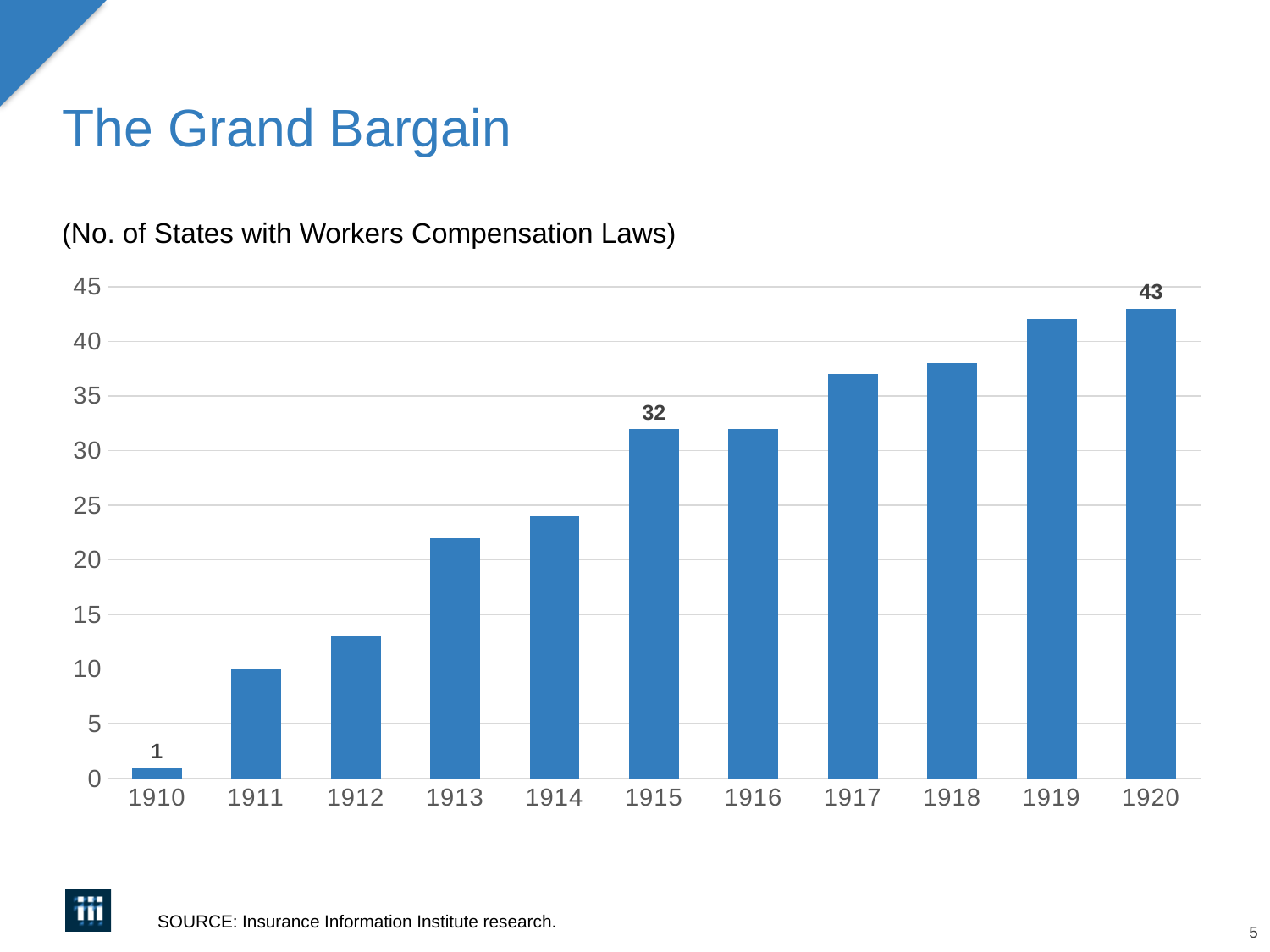
Is the value for 1918 greater or less than 35? greater Which year has the highest number of states with workers compensation laws? 1920 What is the number of states with workers compensation laws in 1920? 43 Is the value for 1912 greater or less than 15? less Which year has a larger value, 1913 or 1917? 1917 What is the number of states with workers compensation laws in 1910? 1 How many more states had workers compensation laws in 1920 than in 1910? 42 What is the difference between the values for 1920 and 1915? 11 How many years are shown on the x axis of the chart? 11 Do the values rise or fall from 1910 to 1920? rise Which year has the lowest number of states with workers compensation laws? 1910 What is the number of states with workers compensation laws in 1915? 32